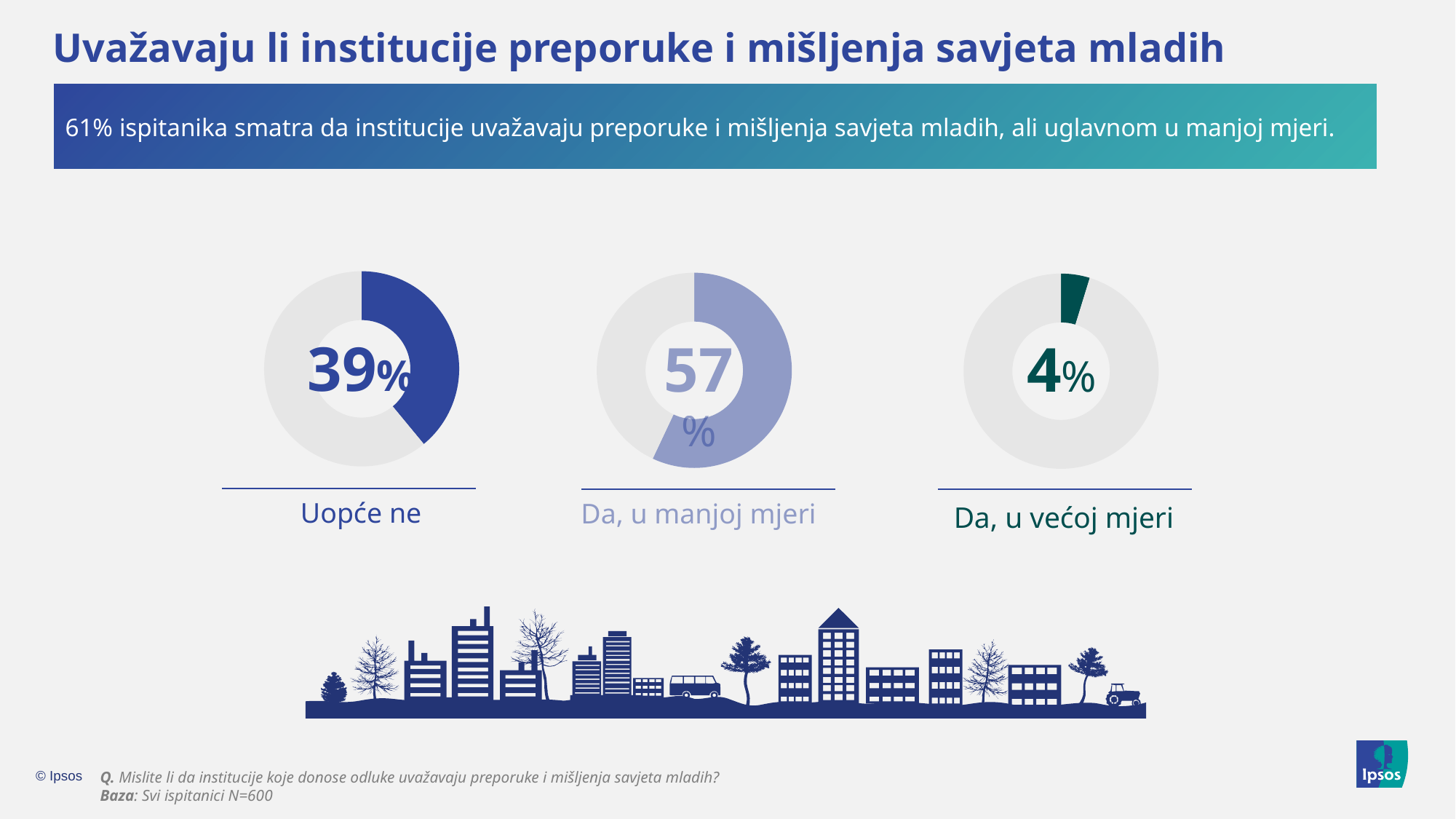
What percentage is shown in the donut chart labelled "Uopće ne"? 39% What is the difference in percentage points between the "Uopće ne" chart and the "Da, u većoj mjeri" chart? 35 Which of the three donut charts shows the highest percentage? Da, u manjoj mjeri What is the combined percentage of the "Da, u manjoj mjeri" and "Da, u većoj mjeri" charts? 61% What percentage is shown in the donut chart labelled "Da, u manjoj mjeri"? 57% How many donut charts are shown on the slide? 3 Which is larger: the value in the "Uopće ne" chart or the value in the "Da, u većoj mjeri" chart? Uopće ne What colour is the filled segment of the donut chart labelled "Da, u većoj mjeri"? Dark green What percentage is shown in the donut chart labelled "Da, u većoj mjeri"? 4% What kind of chart is used to display the three percentages on the slide? Donut (pie) chart Which of the three donut charts shows the lowest percentage? Da, u većoj mjeri What is the difference in percentage points between the "Da, u manjoj mjeri" chart and the "Uopće ne" chart? 18